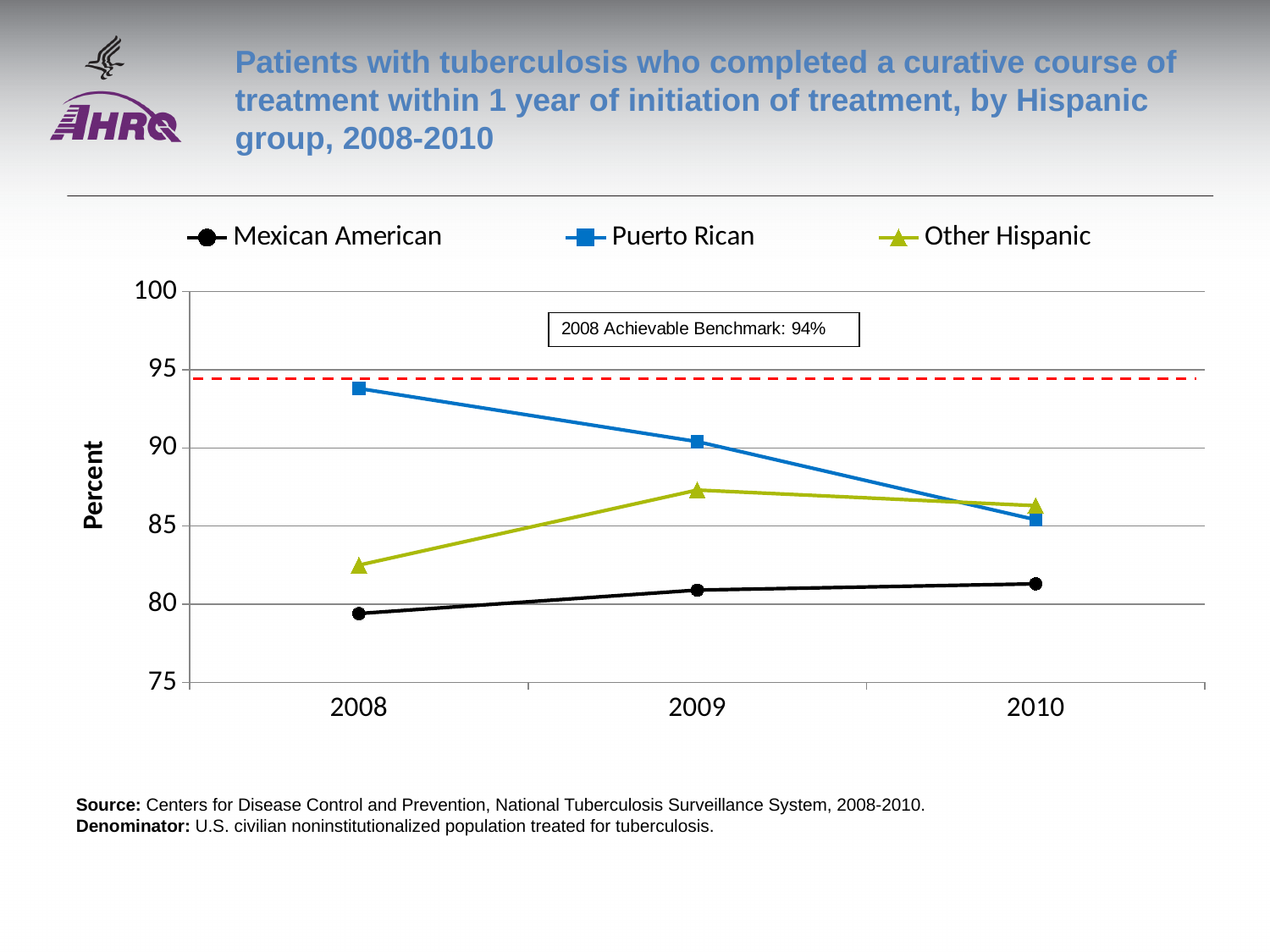
Which group had the highest value in 2008? Puerto Rican How many series does the legend list? 3 What kind of chart is shown on the slide? line chart Is the value for Puerto Rican in 2008 greater or less than 90? greater Is the value for Other Hispanic in 2008 greater or less than 85? less Is the value for Other Hispanic in 2009 greater or less than 85? greater In 2009, which is larger: the value for Other Hispanic or the value for Mexican American? Other Hispanic What is the 2008 Achievable Benchmark shown on the chart? 94% How many years are plotted along the x axis? 3 Which group had the lowest value in 2010? Mexican American Does the value for Puerto Rican rise or fall from 2008 to 2010? fall